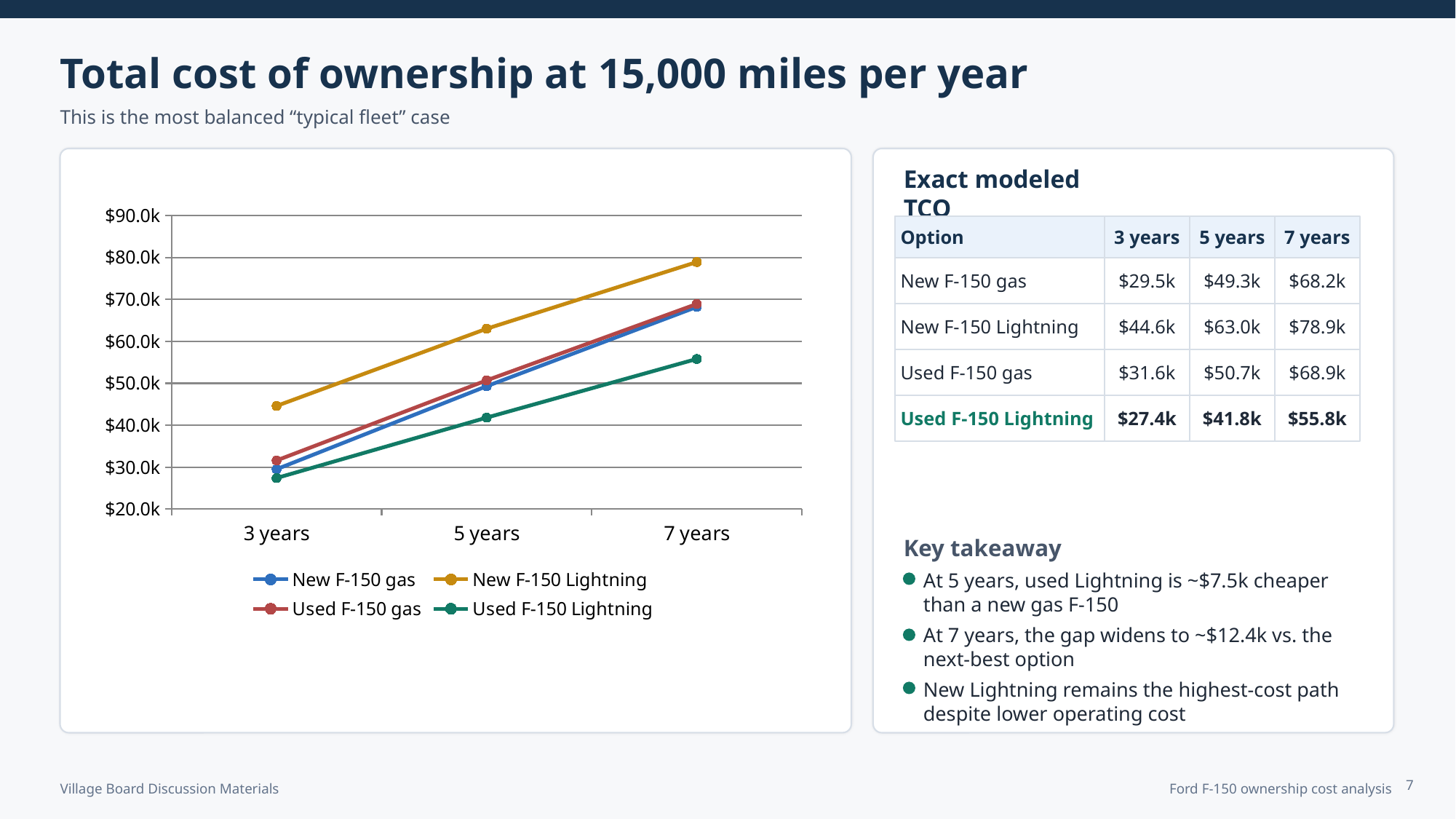
Which option has the lowest total cost of ownership at 7 years? Used F-150 Lightning Using the table values, what is the difference between New F-150 gas and Used F-150 Lightning at 5 years? $7.5k How many time points are plotted along the x axis of the chart? 3 Is the value for Used F-150 Lightning at 5 years greater or less than $50.0k? less Which option has the highest total cost of ownership at 7 years? New F-150 Lightning According to the Exact modeled TCO table, what is the 5-year cost for New F-150 gas? $49.3k What kind of chart is shown on the slide? line chart How many series does the chart legend list? 4 What colour is the Used F-150 Lightning line in the chart? green Is the value for New F-150 Lightning at 3 years greater or less than $40.0k? greater At 5 years, which is larger: New F-150 Lightning or Used F-150 gas? New F-150 Lightning Do the lines in the chart rise or fall from 3 years to 7 years? rise